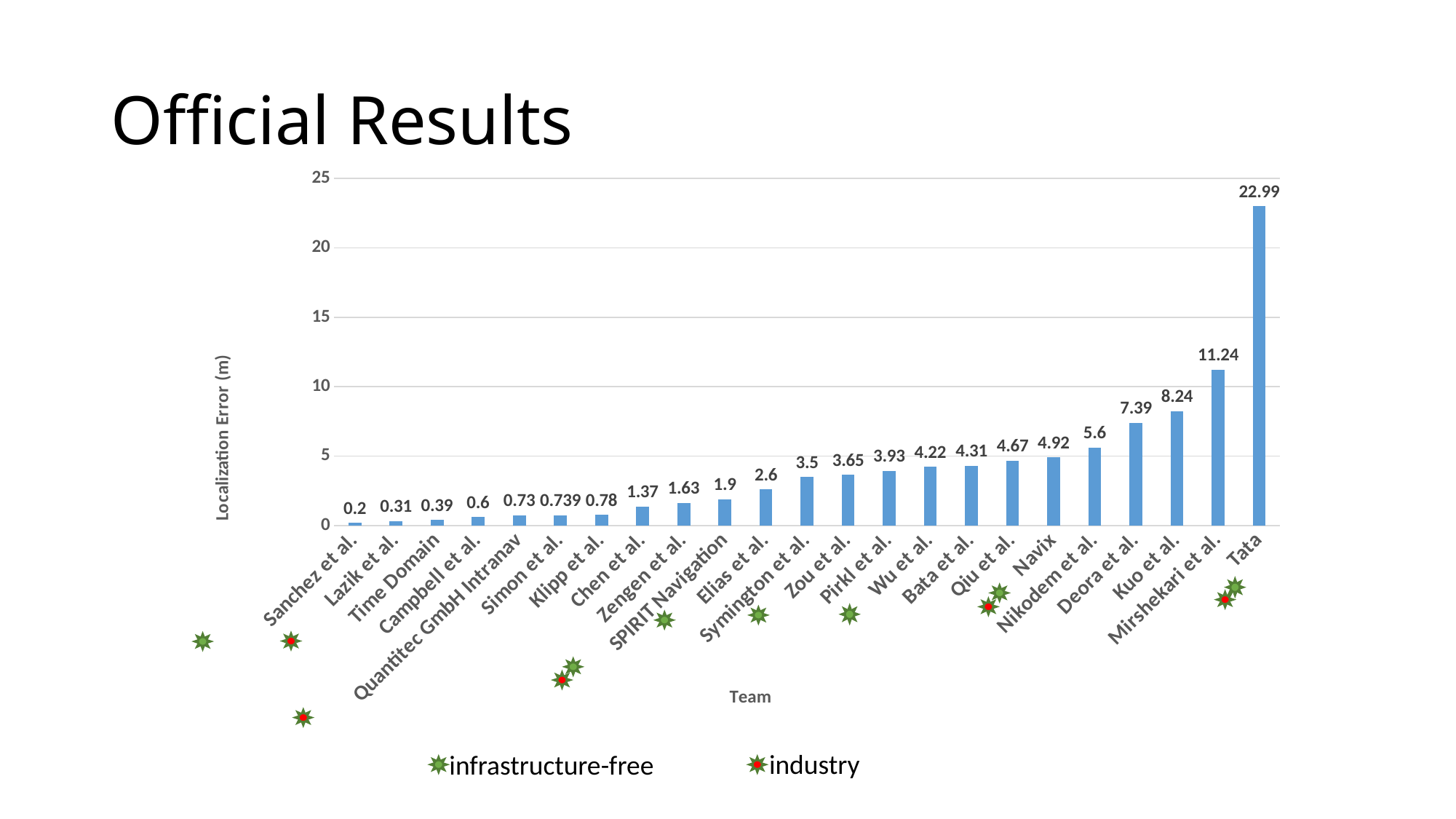
What kind of chart is shown on the slide? bar chart What is the localization error for Tata? 22.99 Do the localization error values rise or fall from left to right along the x axis? rise What is the localization error for Time Domain? 0.39 What is the localization error for Navix? 4.92 Which team has the lowest localization error? Sanchez et al. Is the localization error for Mirshekari et al. greater or less than 10? greater How many teams are shown on the x axis of the chart? 23 Which has a larger localization error, Deora et al. or Kuo et al.? Kuo et al. Which team has the highest localization error? Tata What is the difference in localization error between Tata and Mirshekari et al.? 11.75 What is the label of the vertical axis of the chart? Localization Error (m)